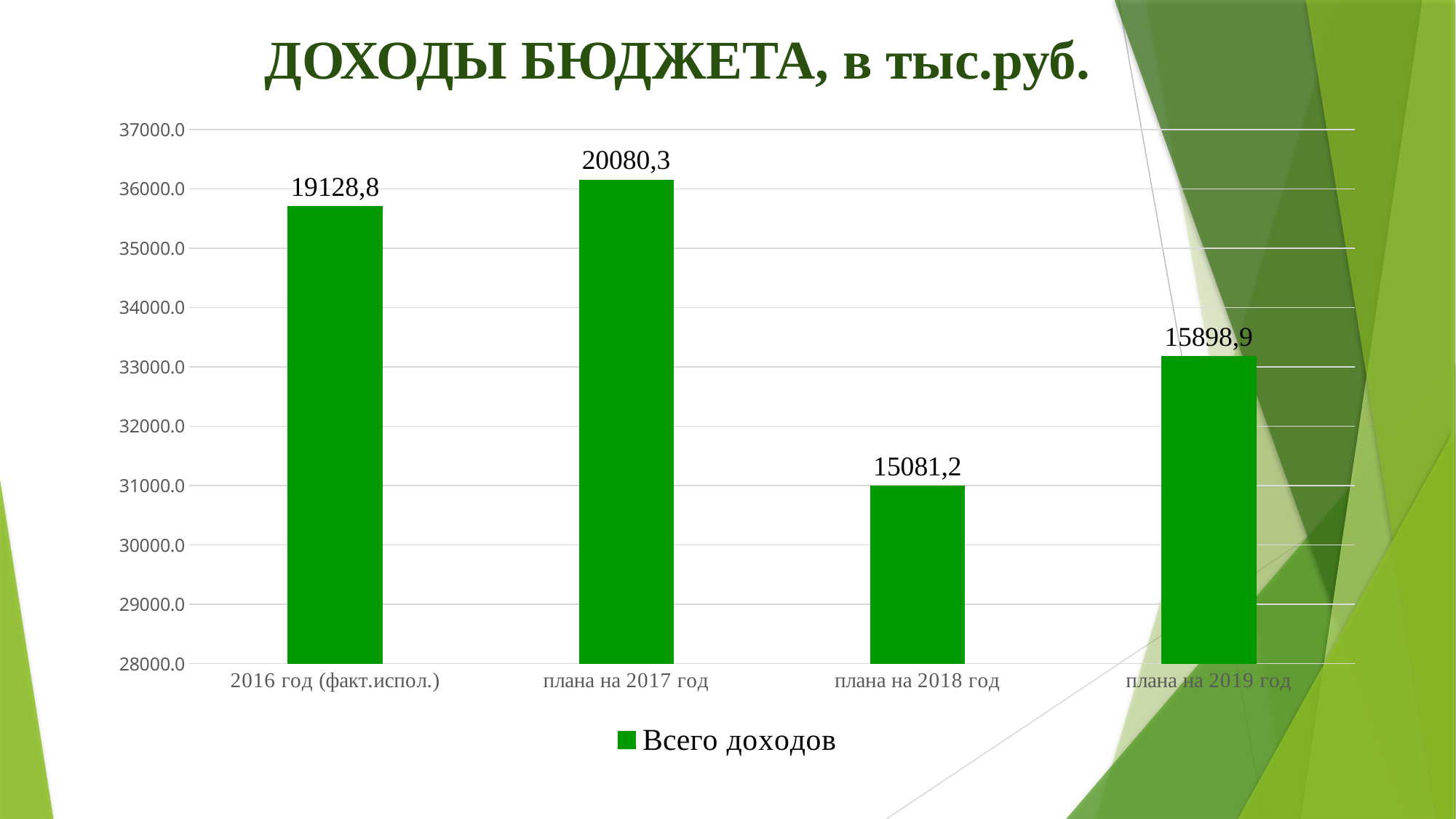
What is the difference between the values for плана на 2017 год and 2016 год (факт.испол.)? 951,5 What is the value for плана на 2019 год? 15898,9 Which is larger: the value for плана на 2019 год or плана на 2018 год? плана на 2019 год What kind of chart is shown on the slide? bar chart How many categories are shown on the x axis? 4 Which category has the lowest value? плана на 2018 год What is the title of the chart? ДОХОДЫ БЮДЖЕТА, в тыс.руб. How many series does the legend list? 1 What is the value for 2016 год (факт.испол.)? 19128,8 What is the value for плана на 2018 год? 15081,2 What is the value for плана на 2017 год? 20080,3 Which category has the highest value? плана на 2017 год